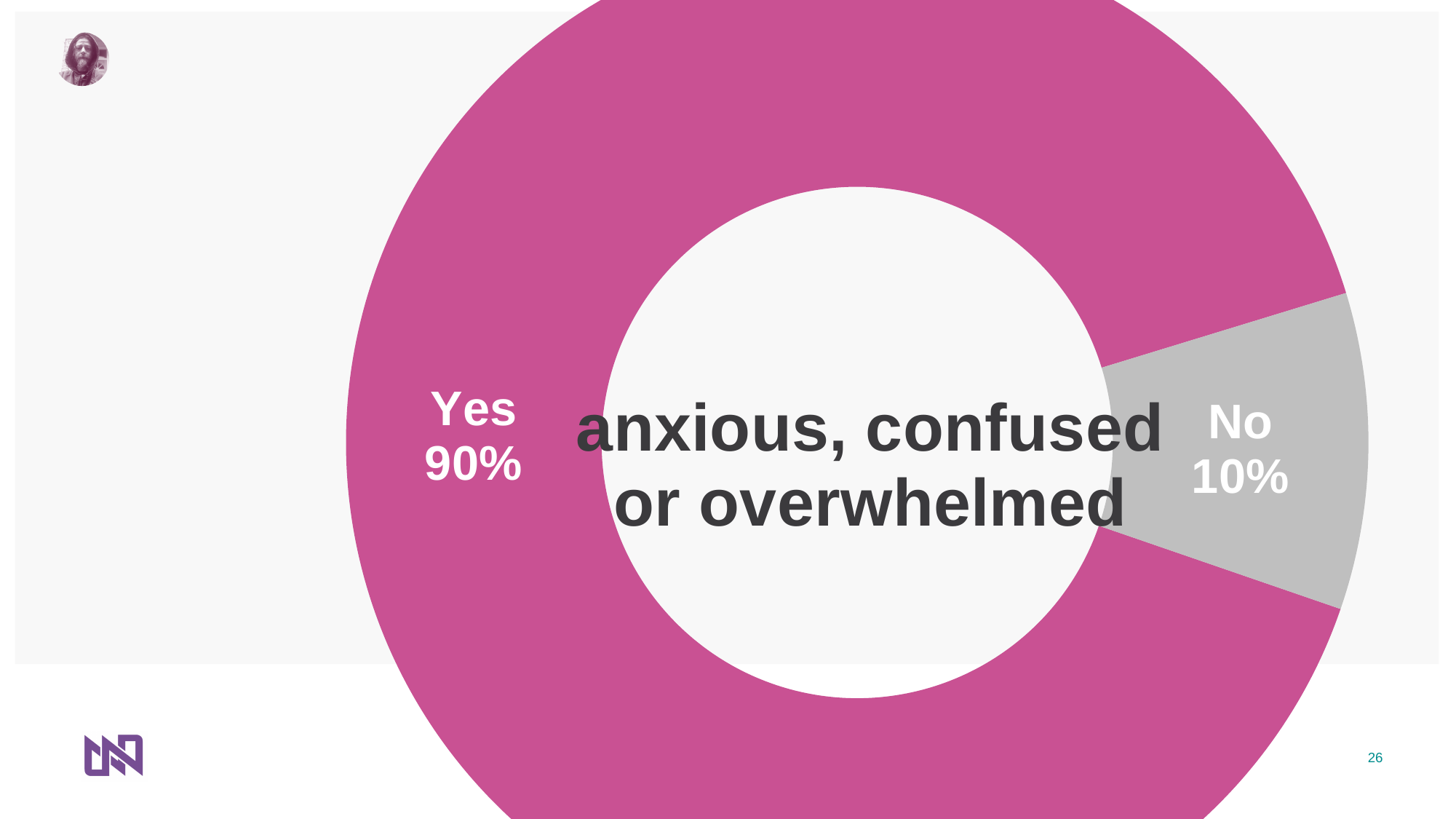
What kind of chart is shown on the slide? Doughnut chart What colour is the "Yes" slice? Magenta/pink Which is larger, the "Yes" slice or the "No" slice? Yes How many slices does the chart have? 2 What percentage is shown for the "No" slice? 10% Which slice is the smallest? No What share of the chart does the "No" slice represent? 10% What percentage is shown for the "Yes" slice? 90% Which slice is the largest? Yes What is the difference in percentage points between the "Yes" and "No" slices? 80 What text is written in the centre of the doughnut chart? anxious, confused or overwhelmed